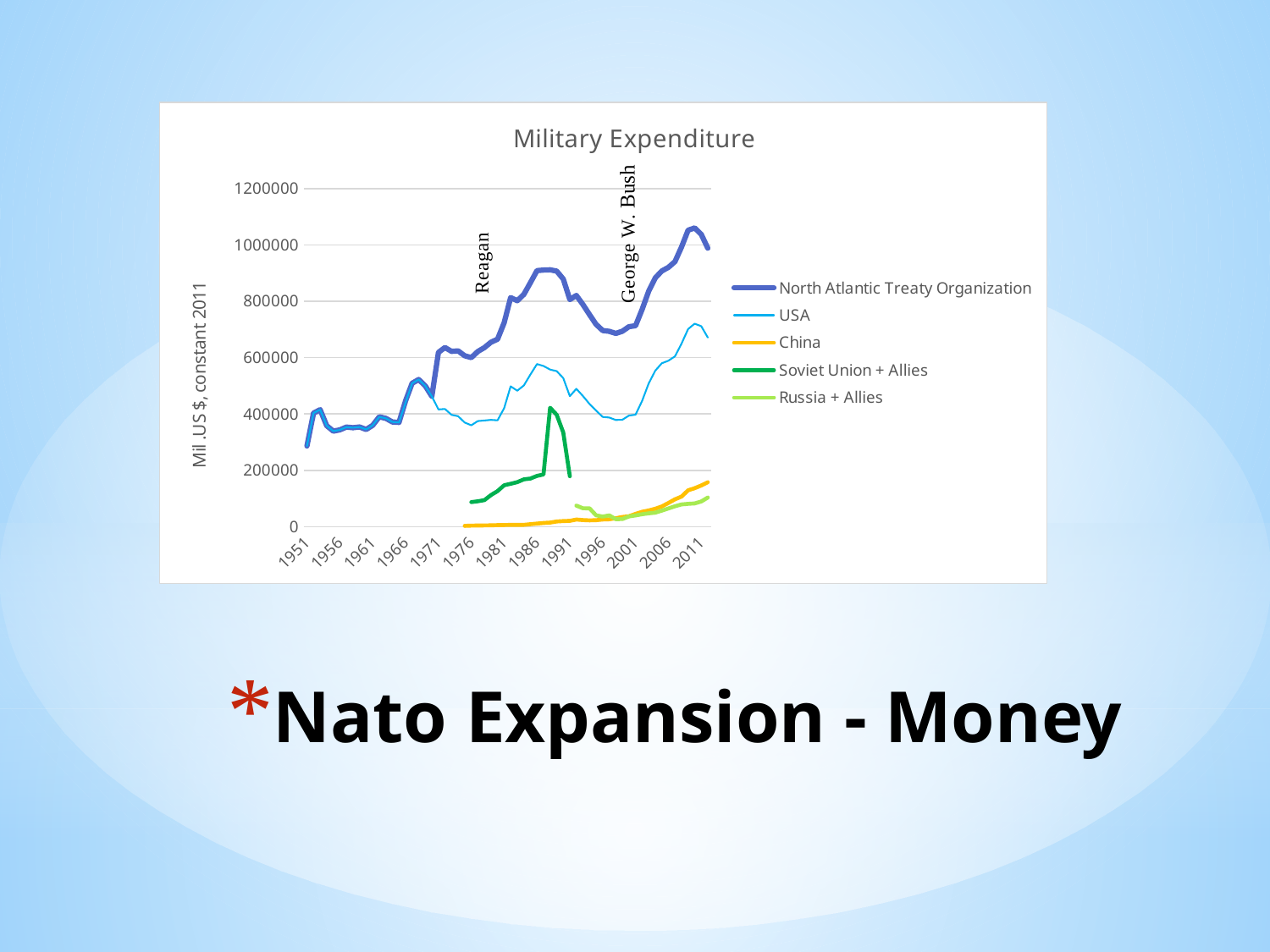
Which series has the highest values across the chart? North Atlantic Treaty Organization Is the value for North Atlantic Treaty Organization in 1951 greater or less than 400000? less Which is larger in 2011, the value for China or the value for Russia + Allies? China Is the value for USA in 2011 greater or less than 600000? greater What is the title of the chart? Military Expenditure How many series does the legend list? 5 Is the value for North Atlantic Treaty Organization in 2011 greater or less than 800000? greater Does the North Atlantic Treaty Organization series generally rise or fall from 1951 to 2011? Rise What kind of chart is shown on the slide? Line chart Which is larger in 2011, the value for North Atlantic Treaty Organization or the value for USA? North Atlantic Treaty Organization What is the label on the vertical axis of the chart? Mil .US $, constant 2011